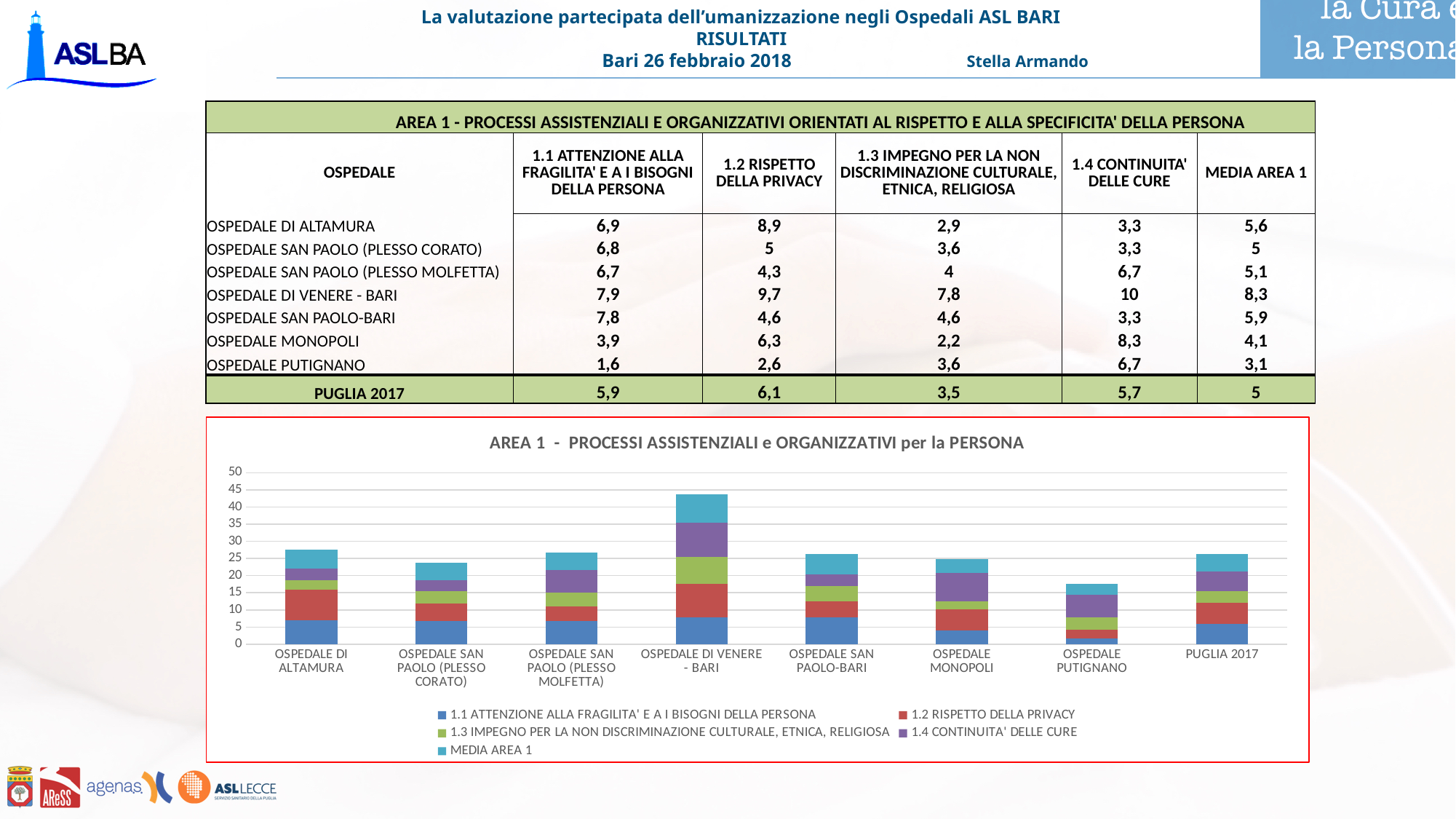
What is the total of the stacked bar for OSPEDALE DI VENERE - BARI, using the values printed in the table? 43,7 Is the total stacked value for OSPEDALE DI VENERE - BARI greater or less than 40? greater Which category has the shortest stacked bar in the chart? OSPEDALE PUTIGNANO Which stacked bar is taller, OSPEDALE DI ALTAMURA or OSPEDALE SAN PAOLO (PLESSO CORATO)? OSPEDALE DI ALTAMURA What is the value of 1.2 RISPETTO DELLA PRIVACY for OSPEDALE DI VENERE - BARI? 9,7 What kind of chart is shown on the slide? Stacked bar chart What is the title of the chart? AREA 1 - PROCESSI ASSISTENZIALI e ORGANIZZATIVI per la PERSONA Is the total stacked value for OSPEDALE PUTIGNANO greater or less than 20? less How many series does the legend of the chart list? 5 Which series is shown in light blue at the top of each stacked bar? MEDIA AREA 1 How many categories are shown along the x axis of the chart? 8 Which category has the tallest stacked bar in the chart? OSPEDALE DI VENERE - BARI